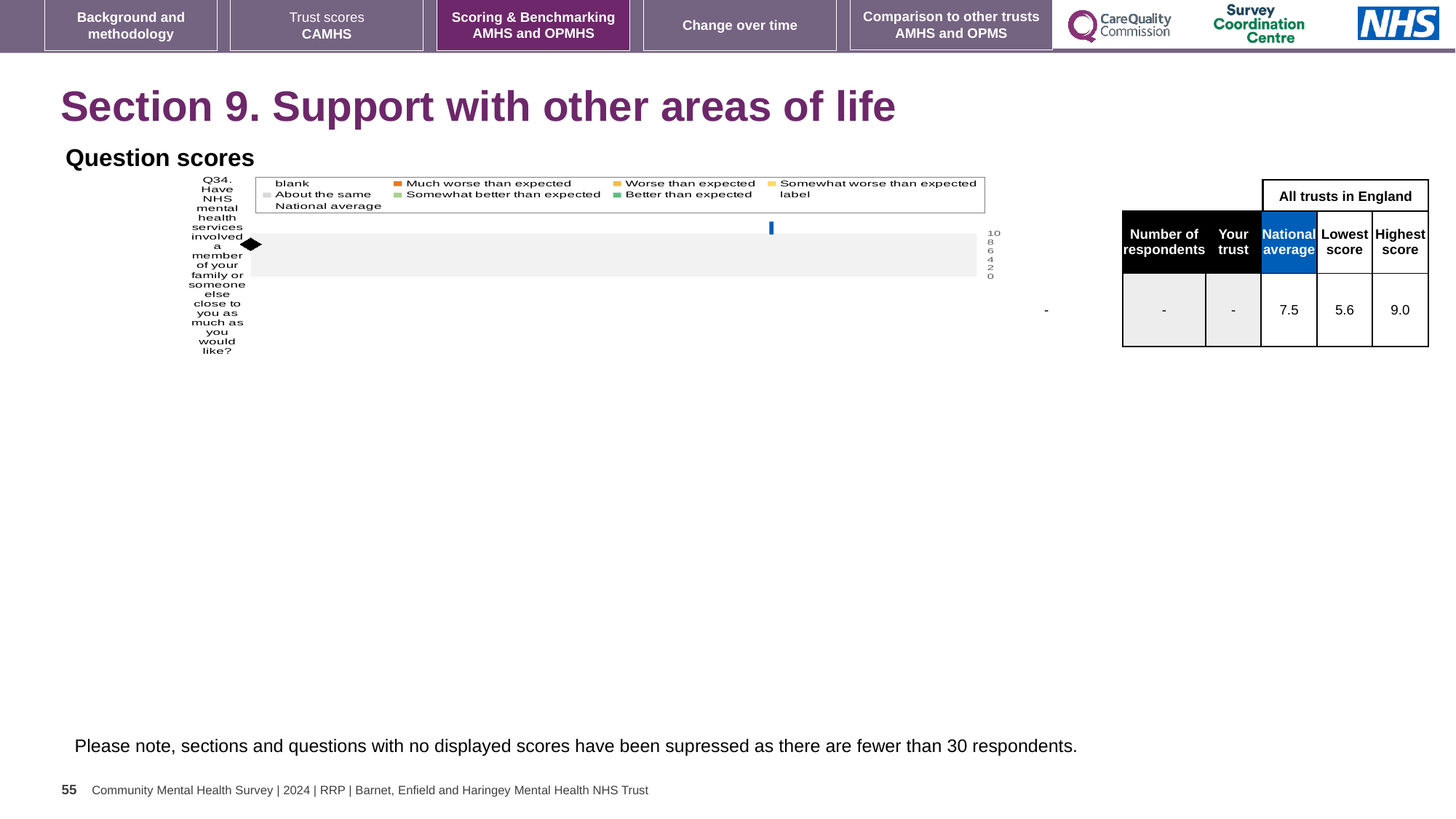
In the table to the right of the chart, what is the highest score among all trusts in England for Q34? 9.0 In the table to the right of the chart, what is the lowest score among all trusts in England for Q34? 5.6 In the table to the right of the chart, what is the difference between the highest score and the lowest score for Q34? 3.4 Which question is shown on the chart's vertical axis? Q34. Have NHS mental health services involved a member of your family or someone else close to you as much as you would like? What is the maximum value shown on the chart's horizontal axis? 10 In the table to the right of the chart, what is the national average score for Q34? 7.5 In the table to the right of the chart, is the national average for Q34 greater or less than 5? greater How many questions (categories) are listed on the chart's vertical axis? 1 In the table to the right of the chart, what is shown for 'Your trust' score for Q34? - What kind of chart is shown under 'Question scores'? bar chart